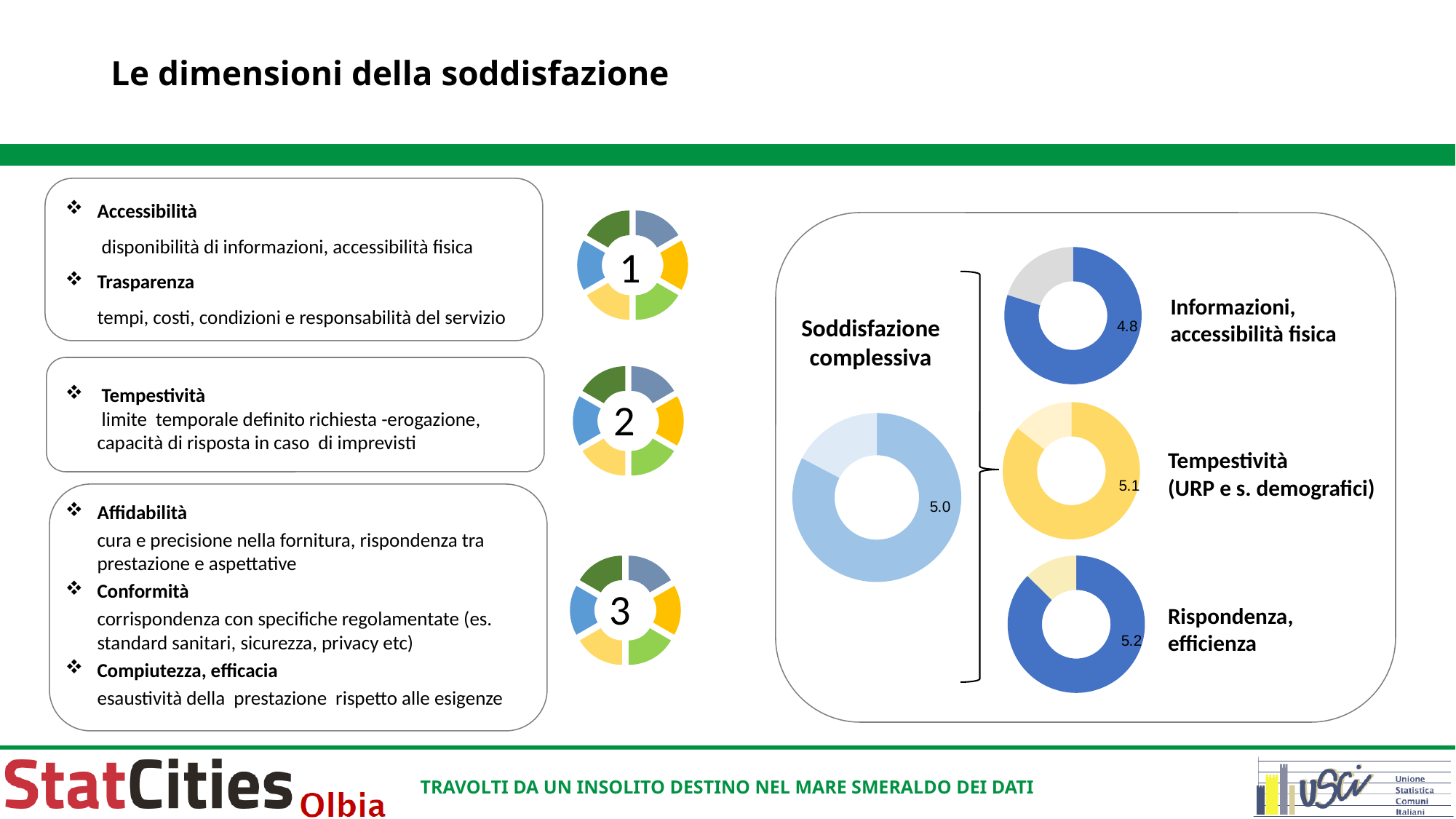
What kind of chart is used to display the satisfaction values in the right-hand panel? Donut chart What colour is the 'Tempestività (URP e s. demografici)' donut chart? Yellow Which is larger: the 'Tempestività (URP e s. demografici)' value or the 'Soddisfazione complessiva' value? Tempestività (URP e s. demografici) What is the difference between the 'Rispondenza, efficienza' value and the 'Informazioni, accessibilità fisica' value? 0.4 Among the three dimension donut charts on the right (Informazioni, Tempestività, Rispondenza), which has the highest value? Rispondenza, efficienza What value is shown on the donut chart labelled 'Informazioni, accessibilità fisica'? 4.8 What value is shown on the 'Soddisfazione complessiva' donut chart? 5.0 What is the difference between the 'Soddisfazione complessiva' value and the 'Informazioni, accessibilità fisica' value? 0.2 What value is shown on the donut chart labelled 'Tempestività (URP e s. demografici)'? 5.1 What value is shown on the donut chart labelled 'Rispondenza, efficienza'? 5.2 How many donut charts with data values are shown in the right-hand panel? 4 Among the three dimension donut charts on the right (Informazioni, Tempestività, Rispondenza), which has the lowest value? Informazioni, accessibilità fisica